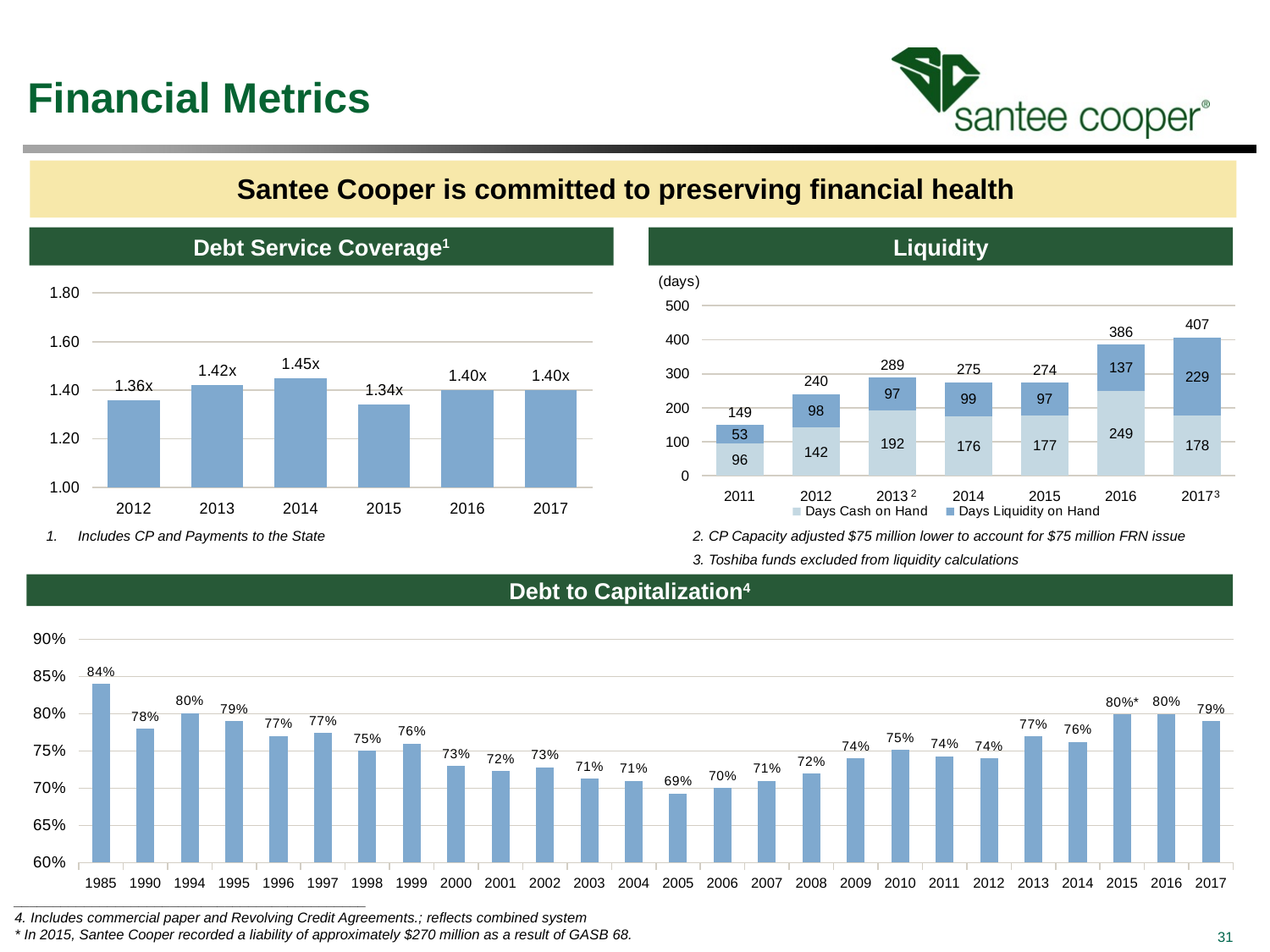
In the Debt to Capitalization chart, is the value for 2013 larger than the value for 2012? Yes In the Liquidity chart, what is the total for the 2017 bar? 407 In the Liquidity chart, how many series does the legend list? 2 What kind of chart is the Debt to Capitalization chart? Bar chart In the Debt Service Coverage chart, what is the value for 2014? 1.45x In the Debt Service Coverage chart, which year has the lowest value? 2015 In the Liquidity chart, what is the Days Cash on Hand value for 2016? 249 In the Liquidity chart, which year has the lowest total? 2011 In the Debt Service Coverage chart, how many years are shown? 6 In the Debt to Capitalization chart, which year has the highest value? 1985 In the Debt to Capitalization chart, what is the value for 2005? 69% In the Liquidity chart, what is the difference between the Days Liquidity on Hand values for 2017 and 2016? 92